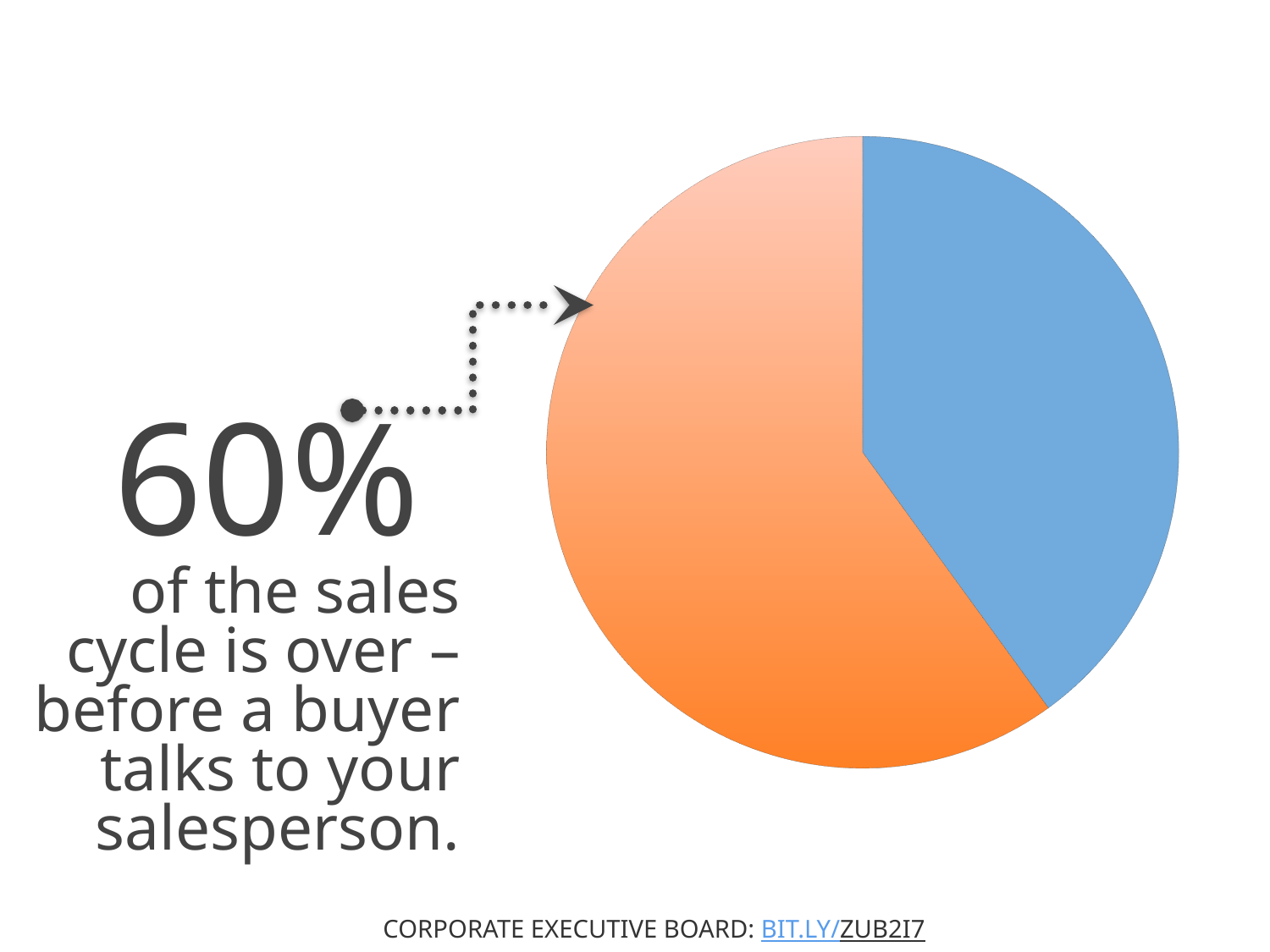
What share of the pie does the blue slice represent? 40% Which slice of the pie is larger, the orange one or the blue one? orange Is the blue slice of the pie greater or less than half of the pie? less What share of the pie does the orange slice represent? 60% According to the slide, what does the 60% slice represent? the share of the sales cycle that is over before a buyer talks to your salesperson Which slice of the pie does the dotted arrow from the 60% figure point to? the orange slice What kind of chart is shown on the slide? pie chart How many slices does the pie chart have? 2 Which slice of the pie chart is the smallest? the blue slice Which slice of the pie chart is the largest? the orange slice